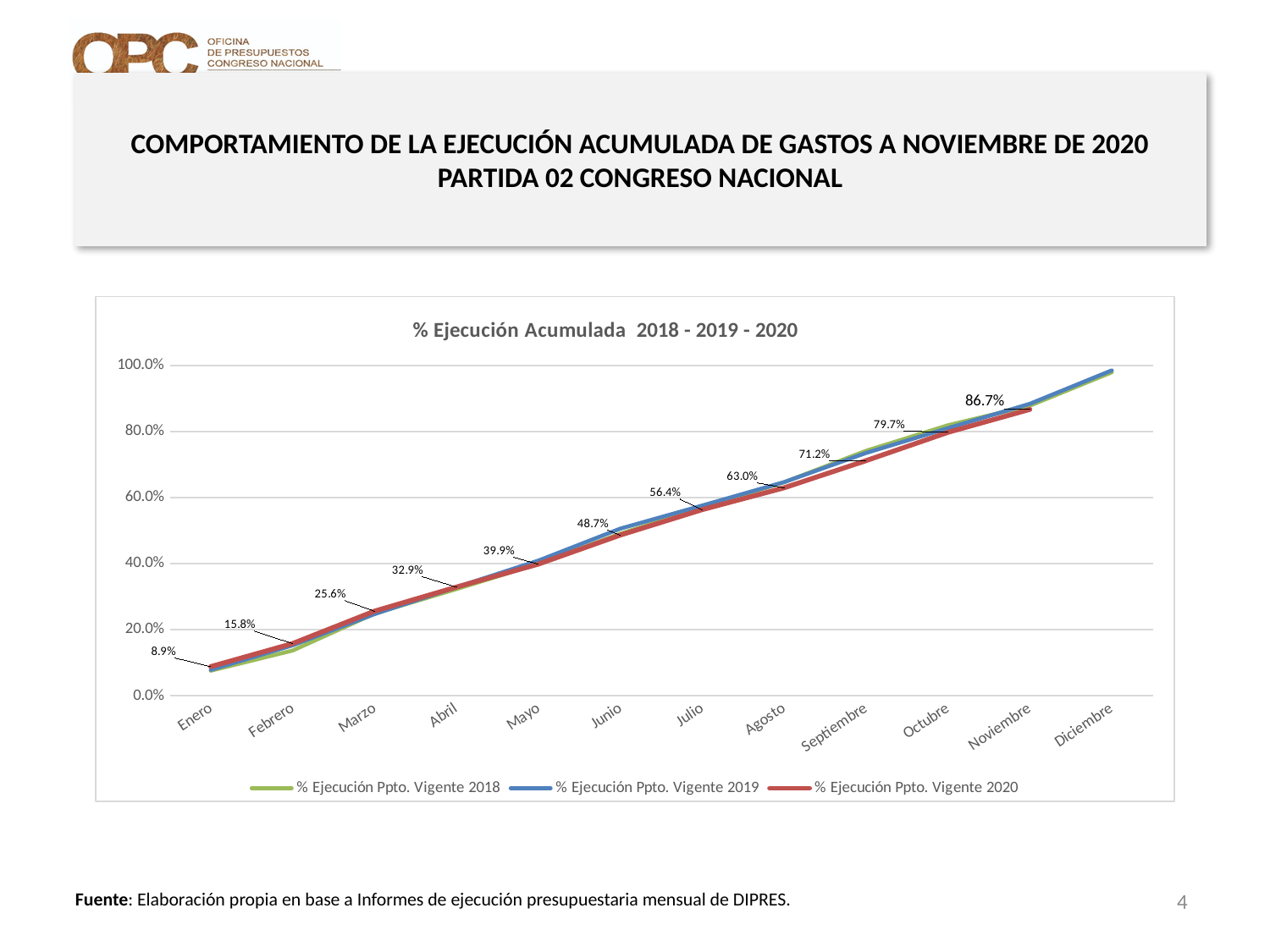
What type of chart is shown on the slide? line chart What is the difference between the 2020 values for Noviembre and Octubre? 7.0% What is the difference between the 2020 values for Agosto and Julio? 6.6% What is the value for % Ejecución Ppto. Vigente 2020 in Noviembre? 86.7% Do the values for % Ejecución Ppto. Vigente 2020 rise or fall from Enero to Noviembre? rise How many series does the legend list? 3 What is the value for % Ejecución Ppto. Vigente 2020 in Junio? 48.7% What is the title of the chart? % Ejecución Acumulada 2018 - 2019 - 2020 What is the value for % Ejecución Ppto. Vigente 2020 in Septiembre? 71.2% What is the value for % Ejecución Ppto. Vigente 2020 in Enero? 8.9% How many months are shown on the x axis? 12 Is the value for % Ejecución Ppto. Vigente 2019 in Diciembre greater or less than 80.0%? greater